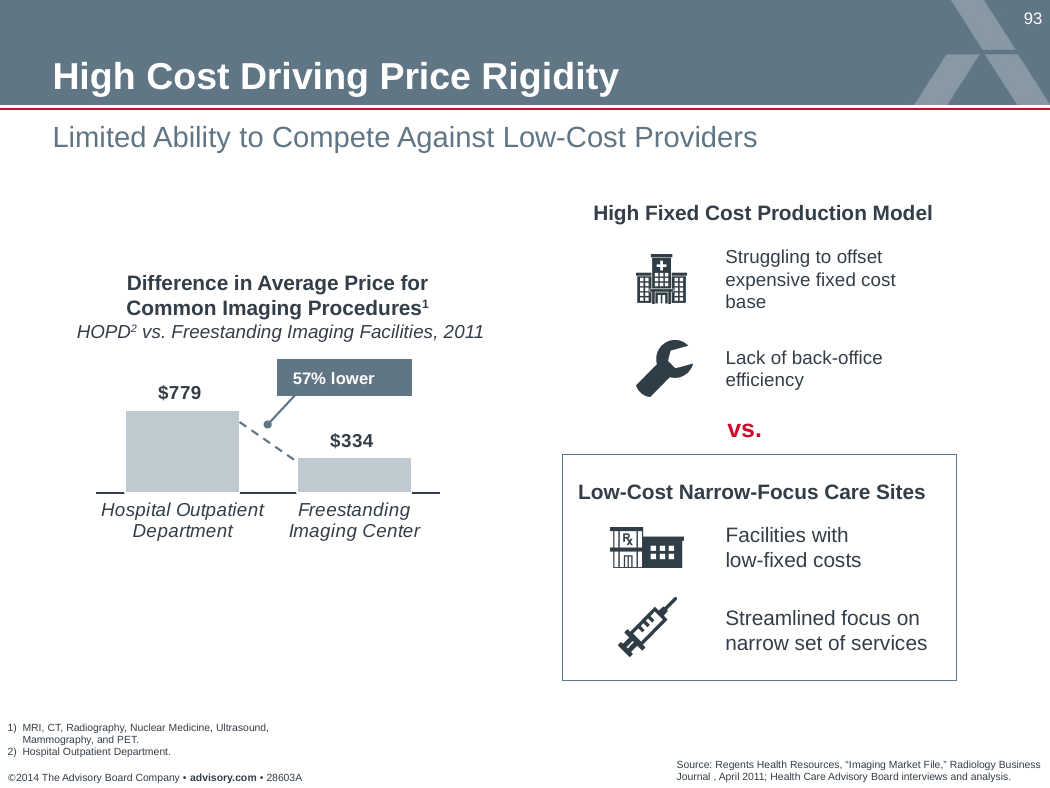
What is the average price for the Hospital Outpatient Department? $779 What is the title of the chart? Difference in Average Price for Common Imaging Procedures What is the average price for the Freestanding Imaging Center? $334 What year does the chart subtitle say the data is from? 2011 By what percentage is the Freestanding Imaging Center price lower, according to the callout on the chart? 57% lower Which category has the higher average price? Hospital Outpatient Department Which category has the lower average price? Freestanding Imaging Center What is the difference in average price between the Hospital Outpatient Department and the Freestanding Imaging Center? $445 How many categories are shown in the chart? 2 What kind of chart is shown on the slide? bar chart Is the average price for the Hospital Outpatient Department larger or smaller than that for the Freestanding Imaging Center? larger